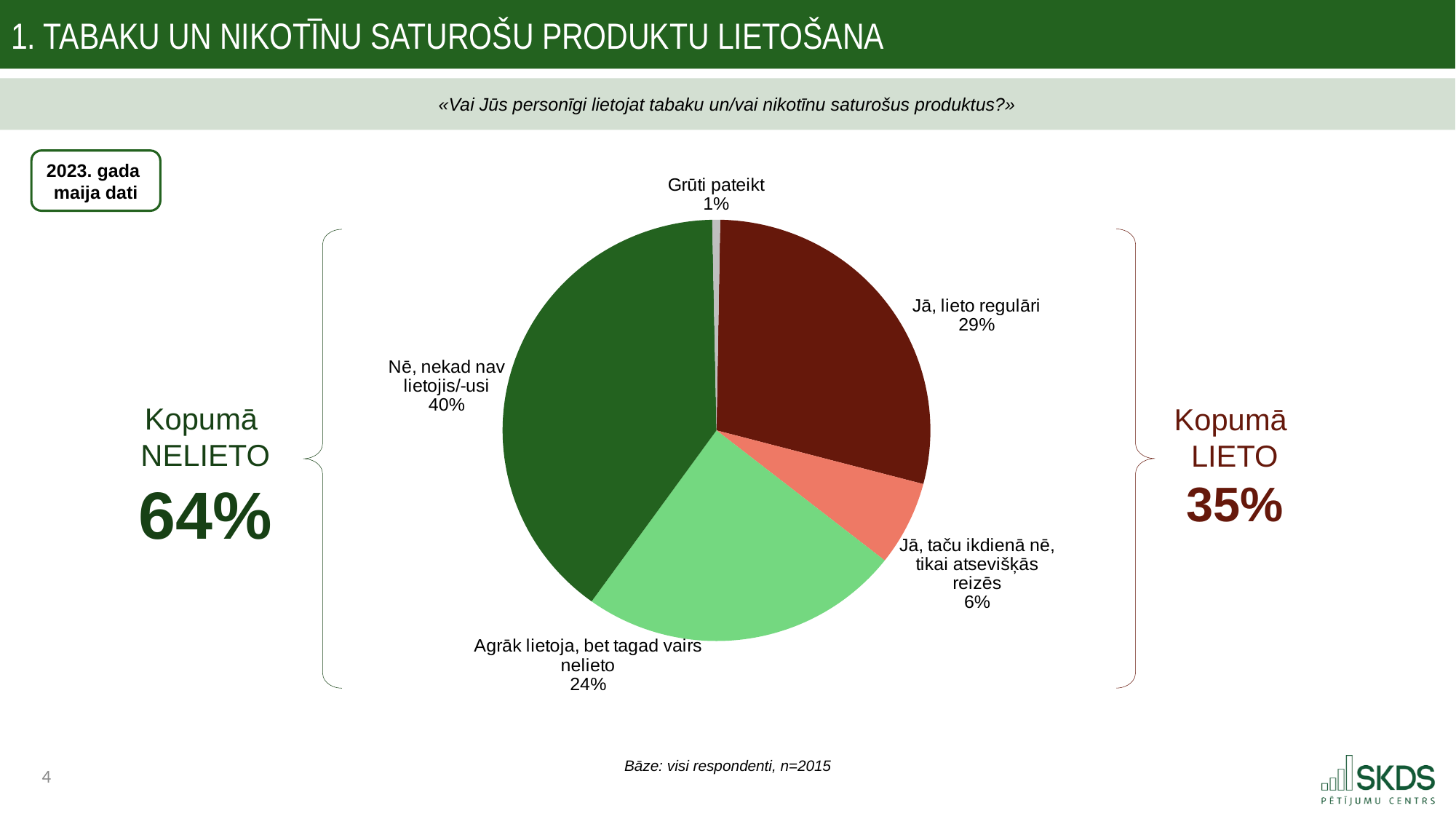
What share of respondents answered "Agrāk lietoja, bet tagad vairs nelieto"? 24% What share of respondents answered "Jā, taču ikdienā nē, tikai atsevišķās reizēs"? 6% What is the difference between the "Nē, nekad nav lietojis/-usi" share and the "Jā, lieto regulāri" share? 11 percentage points What share of respondents answered "Nē, nekad nav lietojis/-usi"? 40% What kind of chart is shown on the slide? pie chart Which slice of the pie chart is the smallest? Grūti pateikt What share of respondents answered "Jā, lieto regulāri"? 29% What total percentage is shown for "Kopumā LIETO"? 35% Which is larger: the share for "Jā, lieto regulāri" or the share for "Agrāk lietoja, bet tagad vairs nelieto"? Jā, lieto regulāri How many slices does the pie chart have? 5 Which slice of the pie chart is the largest? Nē, nekad nav lietojis/-usi What share of respondents answered "Grūti pateikt"? 1%